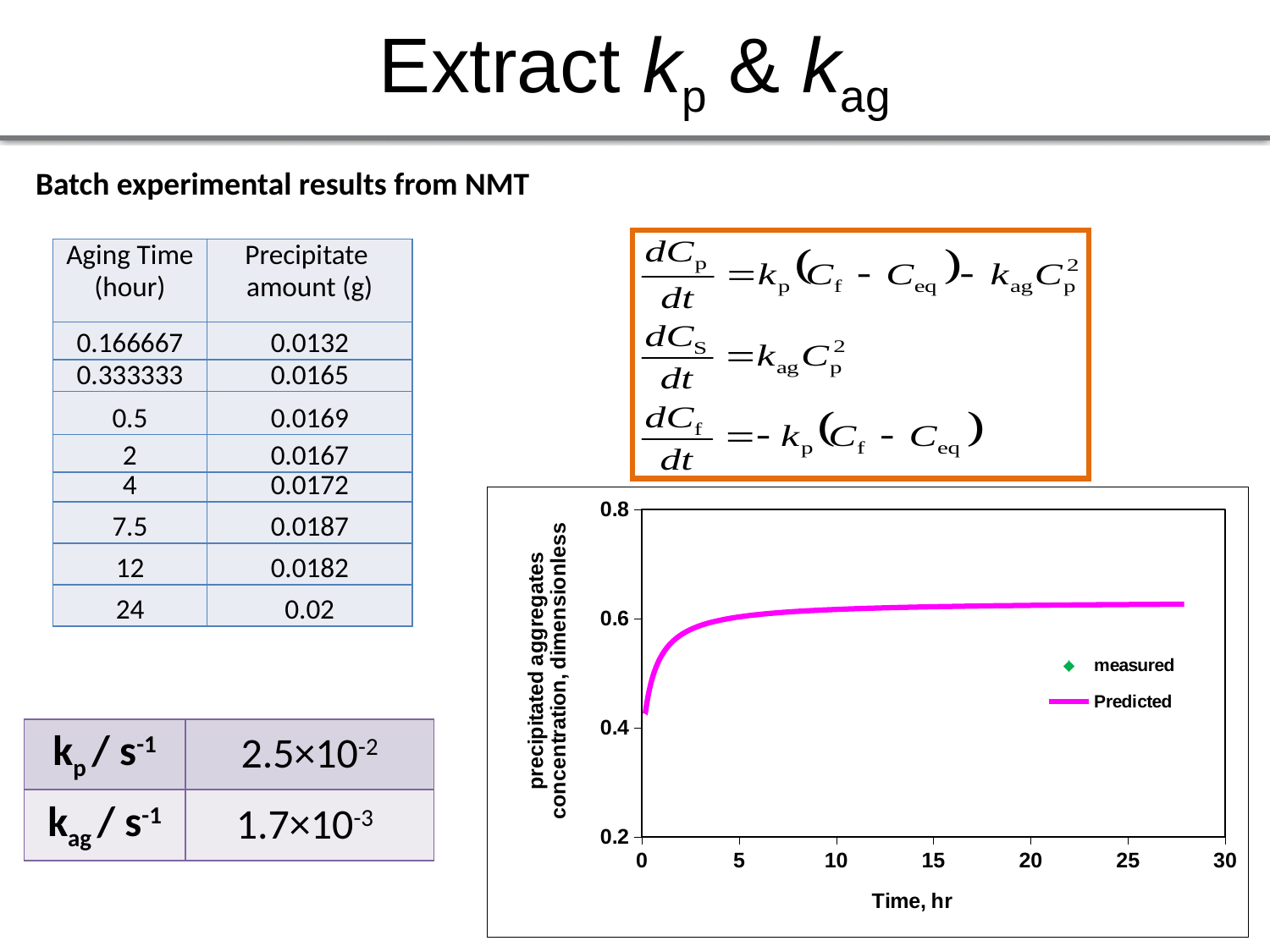
What colour is the Predicted line in the chart? magenta Is the Predicted value at 10 hr greater or less than 0.4? greater How many series does the chart's legend list? 2 Does the Predicted curve rise or fall as time increases along the x axis? rise Is the Predicted value at 25 hr greater or less than 0.8? less Is the Predicted value near time 0 hr greater or less than 0.6? less What is the label of the x axis of the chart? Time, hr What kind of chart is shown on the slide? line chart